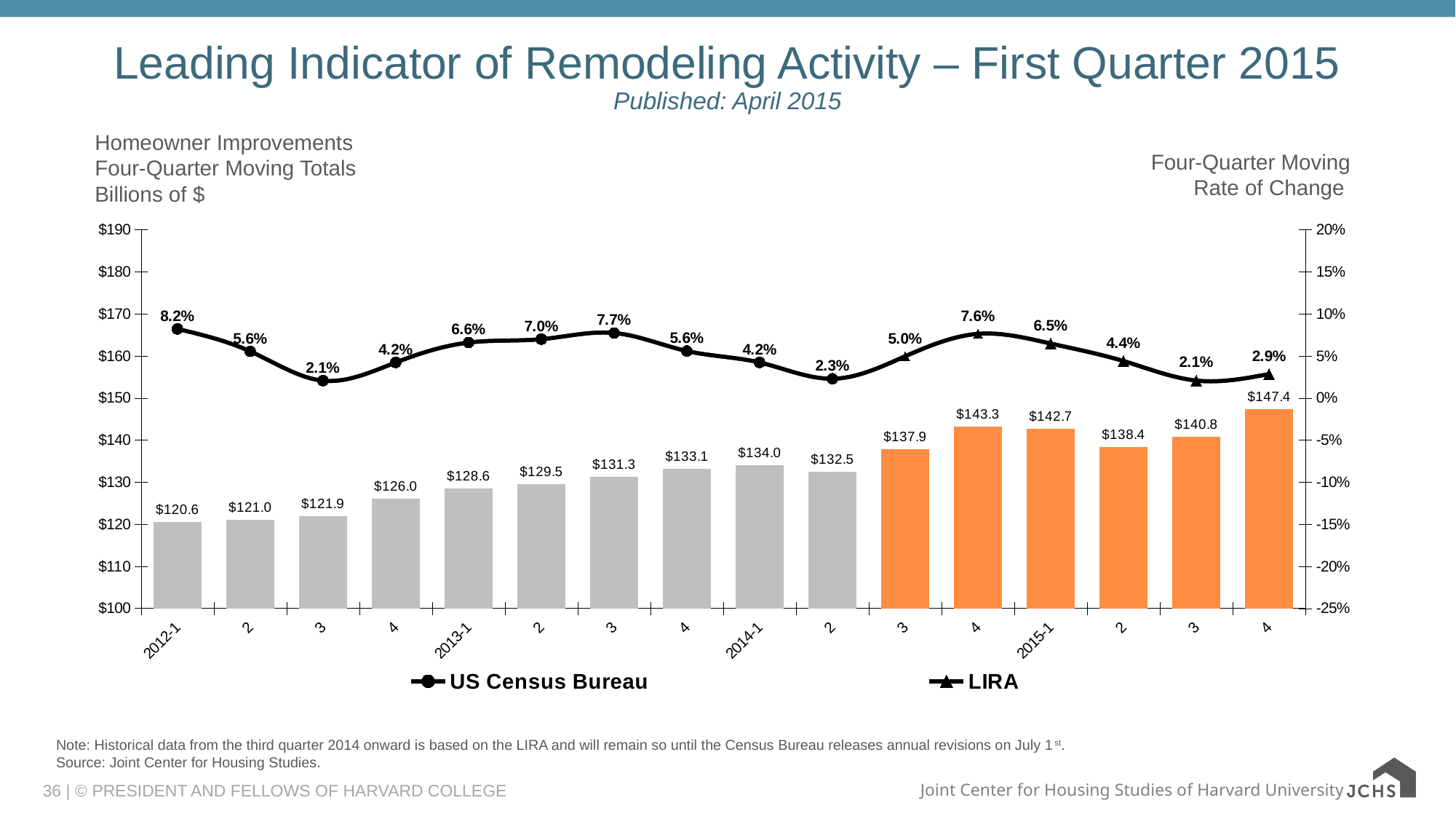
Which quarter has the lowest four-quarter moving total bar? 2012-1 Which is larger, the four-quarter moving total for 2014-2 or for 2014-3? 2014-3 Which quarter has the highest four-quarter moving total bar? 2015-4 What is the four-quarter moving rate of change shown for the last quarter plotted (2015-4)? 2.9% What kind of chart is shown on the slide? Combined bar and line chart How many series does the legend list? 2 How many quarterly bars are plotted on the chart? 16 What is the four-quarter moving rate of change shown for the third quarter of 2013 (2013-3)? 7.7% What are the two series named in the legend? US Census Bureau and LIRA What is the difference between the four-quarter moving totals for 2015-4 ($147.4) and 2015-1 ($142.7)? $4.7 What is the four-quarter moving total for 2014-1? $134.0 Is the four-quarter moving total bar for 2013-4 greater or less than $130? greater